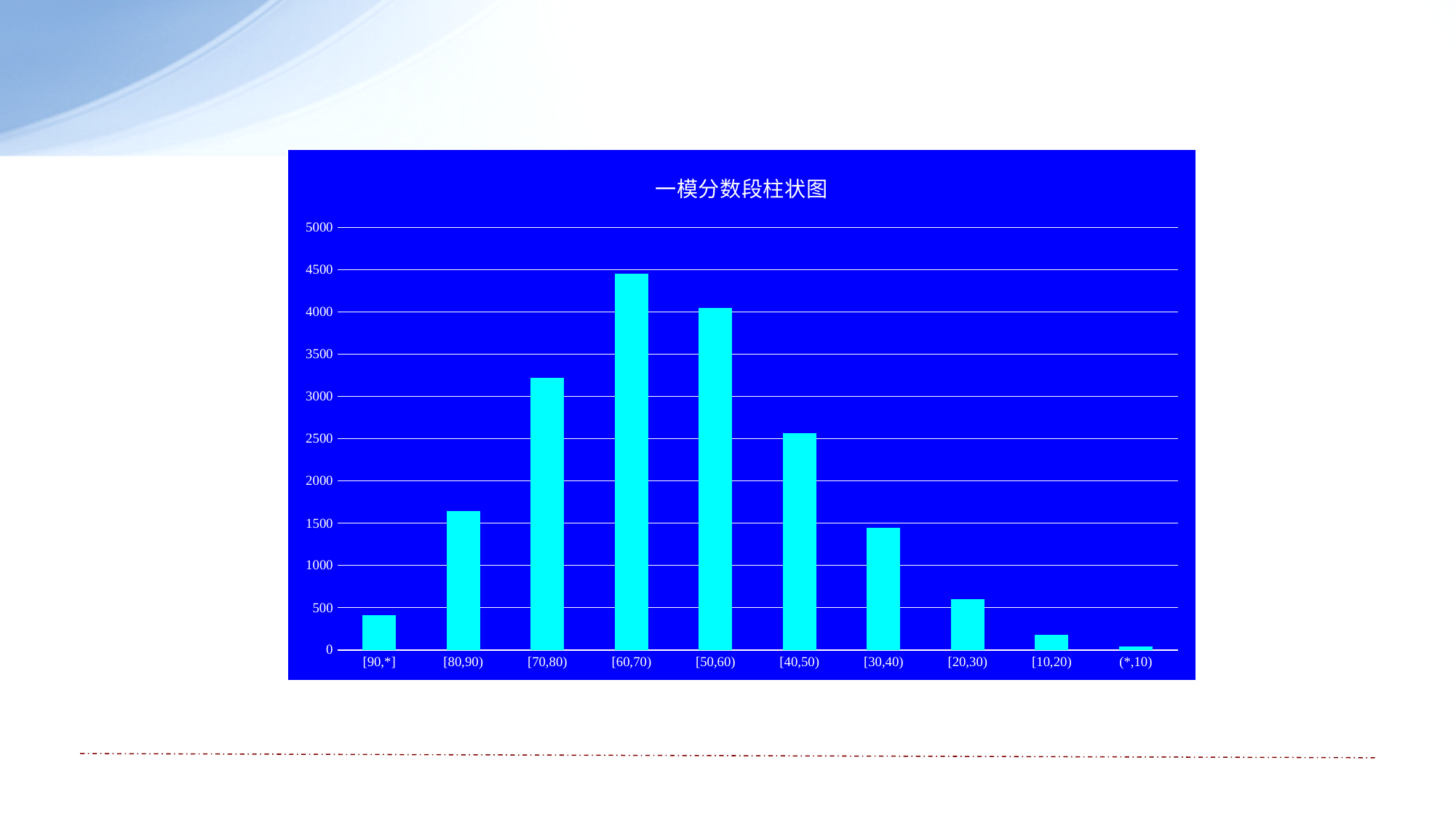
Is the value for [90,*] greater or less than 500? less Is the value for [80,90) greater or less than 1500? greater Do the values rise or fall from [60,70) to (*,10) along the x axis? fall Is the value for [70,80) greater or less than 3500? less What is the title of the chart? 一模分数段柱状图 Which score range has the highest bar? [60,70) Which is larger, the value for [50,60) or the value for [40,50)? [50,60) Which is larger, the value for [30,40) or the value for [20,30)? [30,40) Which score range has the lowest bar? (*,10) What type of chart is shown on the slide? bar chart How many score-range categories are shown on the x axis? 10